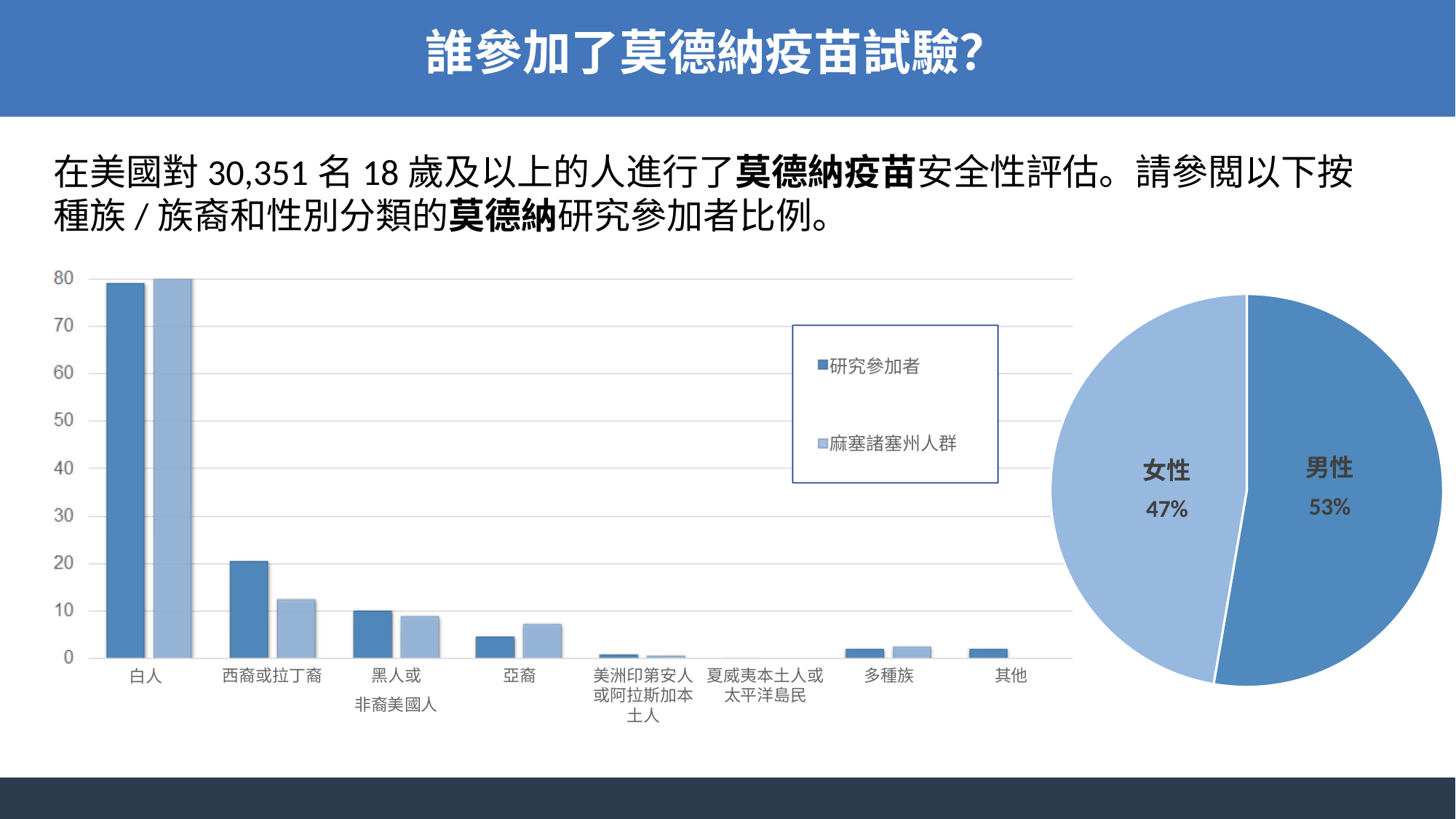
In the bar chart on the left, is the 研究參加者 value for 白人 greater or less than 70? greater In the bar chart on the left, for 亞裔, which series has the larger value, 研究參加者 or 麻塞諸塞州人群? 麻塞諸塞州人群 In the pie chart on the right, what share of participants is 女性? 47% In the bar chart on the left, for 西裔或拉丁裔, which series has the larger value, 研究參加者 or 麻塞諸塞州人群? 研究參加者 In the bar chart on the left, is the 研究參加者 value for 西裔或拉丁裔 greater or less than 30? less What kind of chart is the chart on the left of the slide? bar chart In the pie chart on the right, what share of participants is 男性? 53% In the pie chart on the right, what is the difference between the 男性 share and the 女性 share? 6% In the bar chart on the left, how many series does the legend list? 2 In the pie chart on the right, which slice is larger, 男性 or 女性? 男性 In the bar chart on the left, how many categories are shown on the x axis? 8 In the bar chart on the left, which category has the highest value for 研究參加者? 白人